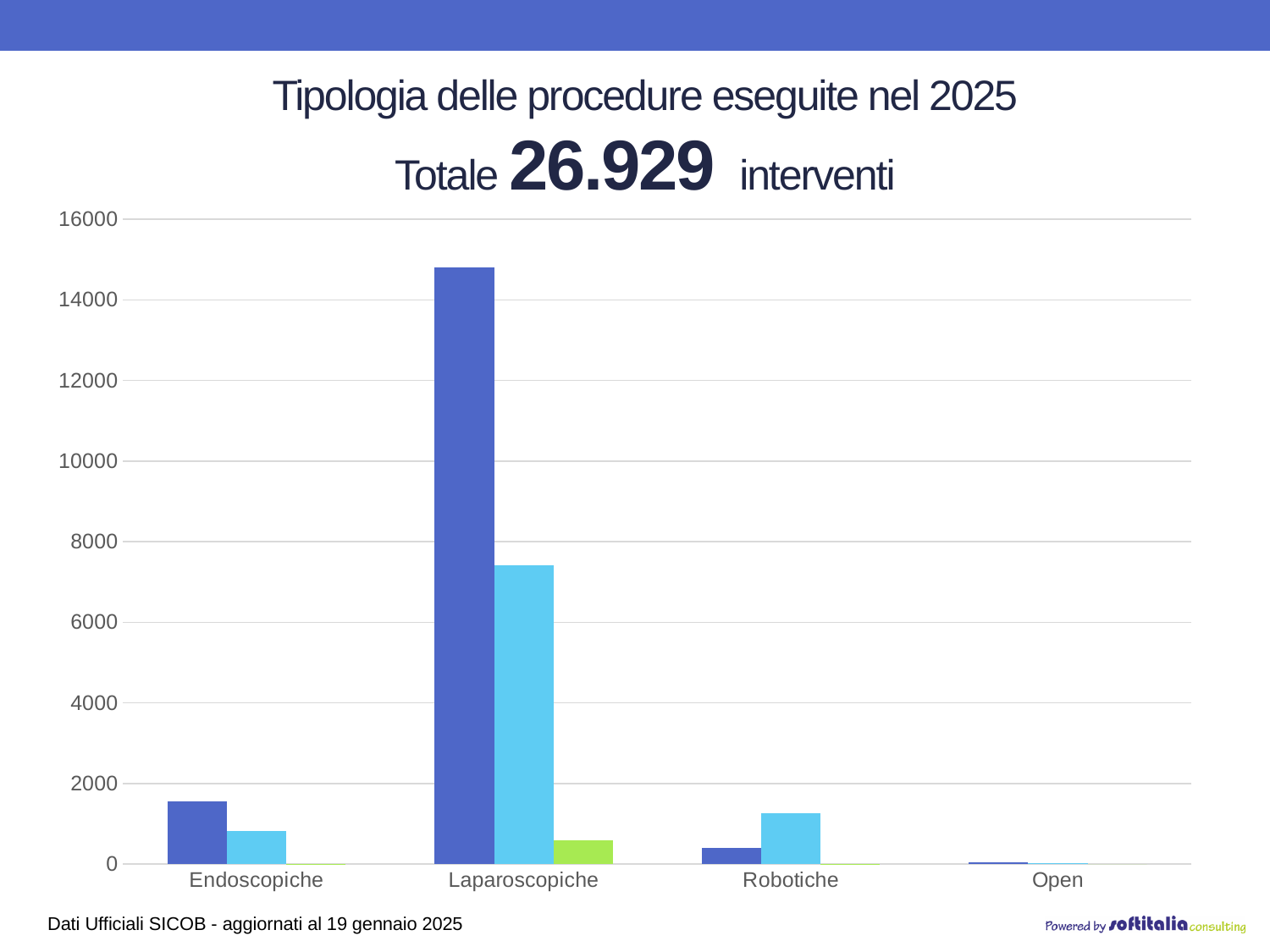
Which is larger: the dark blue bar for Endoscopiche or the dark blue bar for Robotiche? Endoscopiche Is the value of the green bar for Laparoscopiche greater or less than 2000? less Is the value of the dark blue bar for Endoscopiche greater or less than 2000? less Which category has the tallest bar in the chart? Laparoscopiche Which category has the smallest bars in the chart? Open How many categories are shown on the x axis of the chart? 4 What total number of interventions is stated in the chart title? 26.929 Is the value of the dark blue bar for Laparoscopiche greater or less than 14000? greater Which is larger: the light blue bar for Robotiche or the light blue bar for Endoscopiche? Robotiche What kind of chart is shown on the slide? bar chart